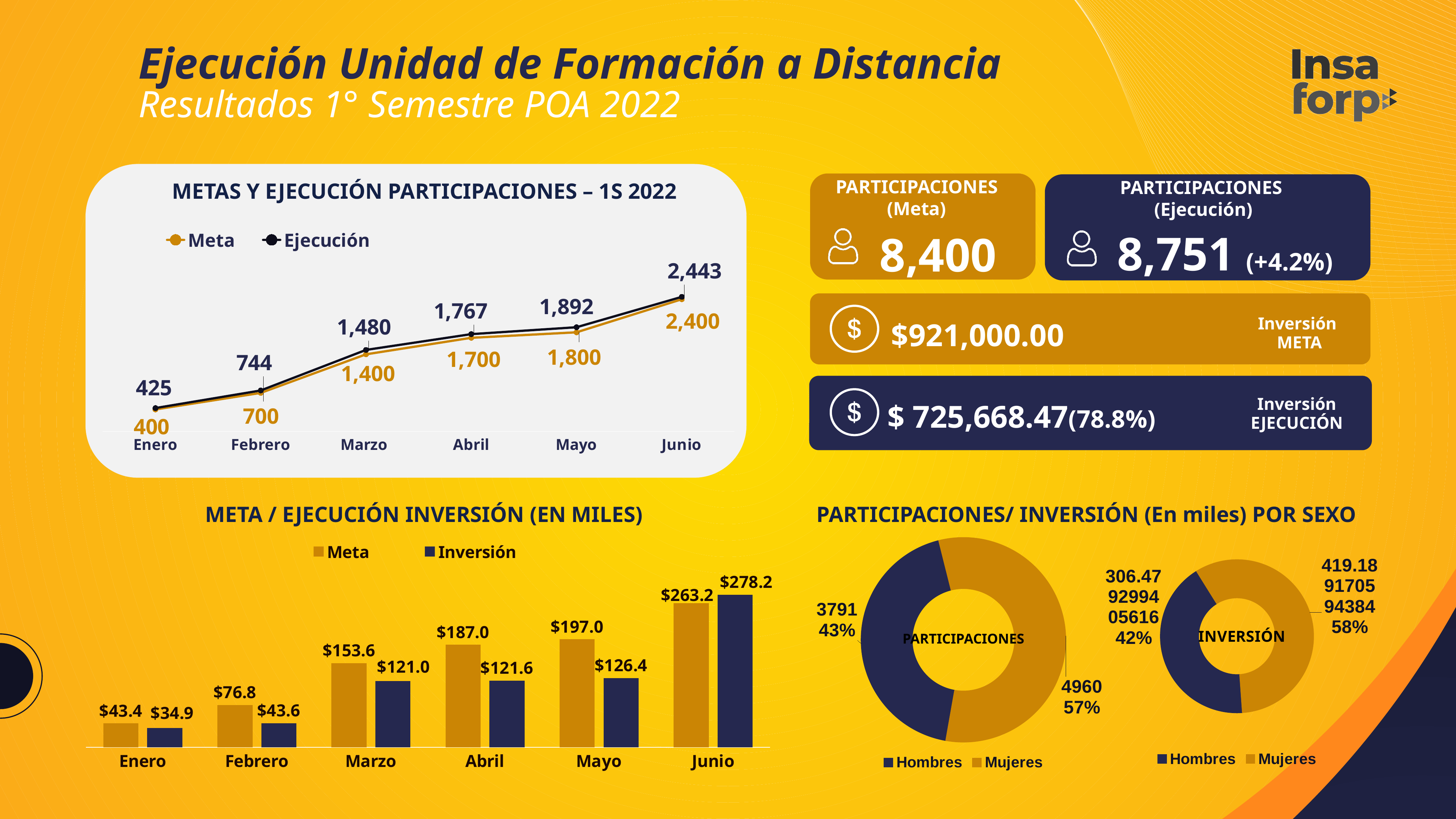
In the chart 'META / EJECUCIÓN INVERSIÓN (EN MILES)', what is the Inversión value for Abril? $121.6 In the 'INVERSIÓN' donut chart, what share corresponds to Hombres? 42% How many series does the legend of the chart 'METAS Y EJECUCIÓN PARTICIPACIONES – 1S 2022' list? 2 In the chart 'META / EJECUCIÓN INVERSIÓN (EN MILES)', which is larger for Junio, Meta or Inversión? Inversión In the chart 'METAS Y EJECUCIÓN PARTICIPACIONES – 1S 2022', do the Ejecución values rise or fall from Enero to Junio? rise How many months are shown on the x axis of the chart 'META / EJECUCIÓN INVERSIÓN (EN MILES)'? 6 In the chart 'METAS Y EJECUCIÓN PARTICIPACIONES – 1S 2022', what is the Meta value for Marzo? 1,400 In the chart 'META / EJECUCIÓN INVERSIÓN (EN MILES)', which month has the highest Meta value? Junio In the chart 'METAS Y EJECUCIÓN PARTICIPACIONES – 1S 2022', what is the Ejecución value for Junio? 2,443 In the 'PARTICIPACIONES' donut chart, what share corresponds to Mujeres? 57% In the chart 'METAS Y EJECUCIÓN PARTICIPACIONES – 1S 2022', by how much does Ejecución exceed Meta in Mayo? 92 In the chart 'META / EJECUCIÓN INVERSIÓN (EN MILES)', what is the difference between Meta and Inversión in Marzo? $32.6